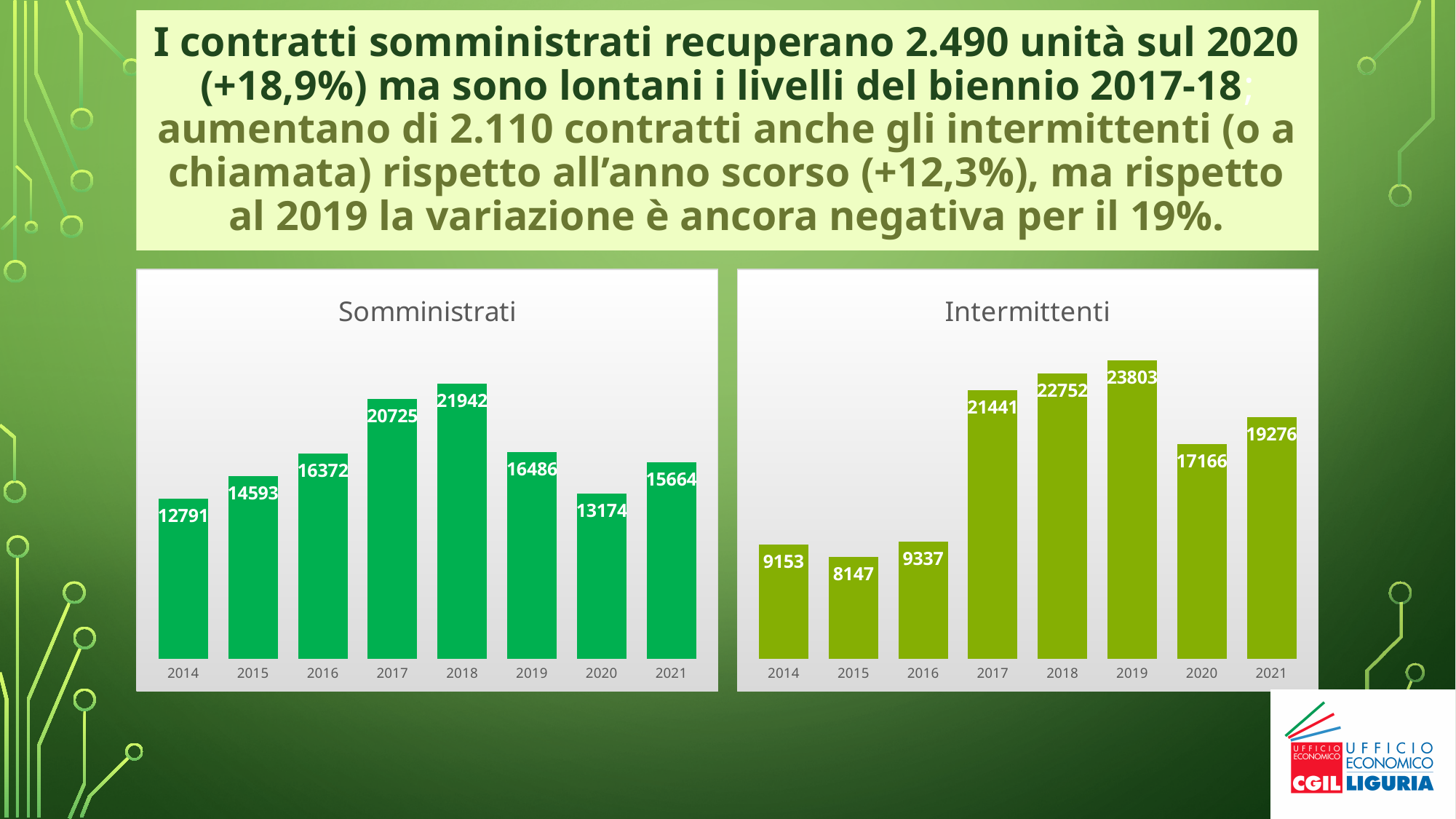
In the Intermittenti chart, which is larger, the value for 2014 or the value for 2016? 2016 In the Intermittenti chart, what is the value for 2020? 17166 In the Somministrati chart, which is larger, the value for 2016 or the value for 2019? 2019 In the Somministrati chart, what is the difference between the 2021 and 2020 values? 2490 In the Intermittenti chart, what is the difference between the 2019 and 2021 values? 4527 How many years are shown in the Somministrati chart? 8 In the Somministrati chart, which year has the highest value? 2018 What is the title of the chart on the left side of the slide? Somministrati In the Intermittenti chart, which year has the lowest value? 2015 In the Intermittenti chart, do the values rise or fall from 2016 to 2019? rise What kind of chart is the Intermittenti chart? bar chart In the Somministrati chart, what is the value for 2018? 21942